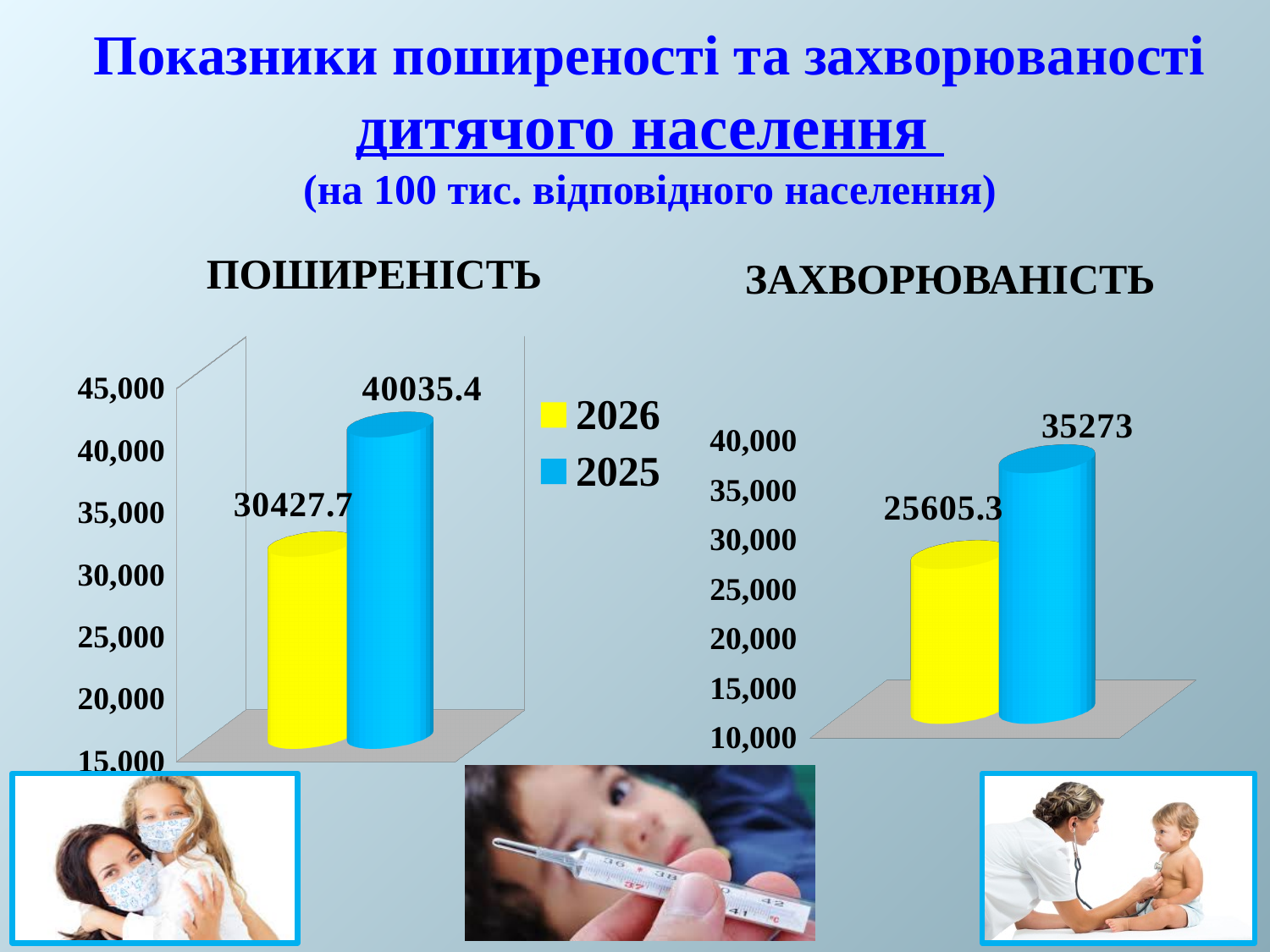
In the ПОШИРЕНІСТЬ chart, which colour represents 2026 in the legend? yellow In the ПОШИРЕНІСТЬ chart, what is the value for 2025? 40035.4 How many series does the legend of the ПОШИРЕНІСТЬ chart list? 2 In the ЗАХВОРЮВАНІСТЬ chart, is the yellow bar's value greater or less than 30,000? less What type of chart is the ЗАХВОРЮВАНІСТЬ chart? bar chart In the ЗАХВОРЮВАНІСТЬ chart, what is the difference between the blue bar and the yellow bar? 9667.7 In the ПОШИРЕНІСТЬ chart, what is the difference between the 2025 and 2026 values? 9607.7 In the ЗАХВОРЮВАНІСТЬ chart, what is the value shown on the blue bar? 35273 In the ПОШИРЕНІСТЬ chart, is the 2025 value greater or less than 35,000? greater In the ПОШИРЕНІСТЬ chart, which year has the higher value? 2025 In the ПОШИРЕНІСТЬ chart, what is the value for 2026? 30427.7 In the ЗАХВОРЮВАНІСТЬ chart, what is the value shown on the yellow bar? 25605.3